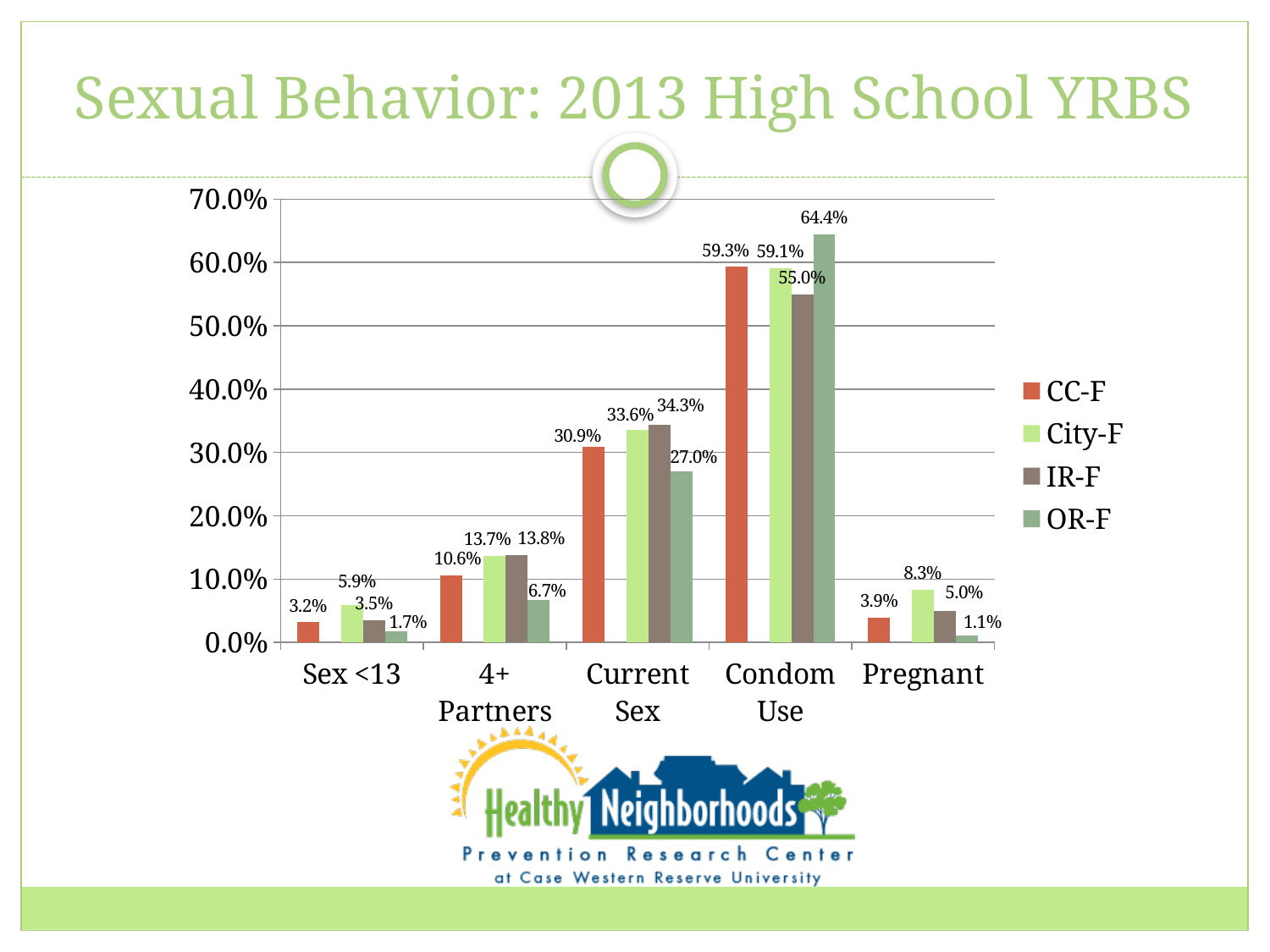
What is the value for City-F in the Pregnant category? 8.3% What kind of chart is shown on the slide? Bar chart What is the difference between the CC-F and OR-F values in the Condom Use category? 5.1% What is the value for CC-F in the Current Sex category? 30.9% Which series has the lowest value in the Sex <13 category? OR-F Which series has the highest value in the Condom Use category? OR-F How many series does the legend list? 4 Which is larger in the Current Sex category: the IR-F value or the OR-F value? IR-F What is the value for OR-F in the Condom Use category? 64.4% What is the value for IR-F in the 4+ Partners category? 13.8% What is the title of the slide containing the chart? Sexual Behavior: 2013 High School YRBS How many categories are shown on the x axis? 5